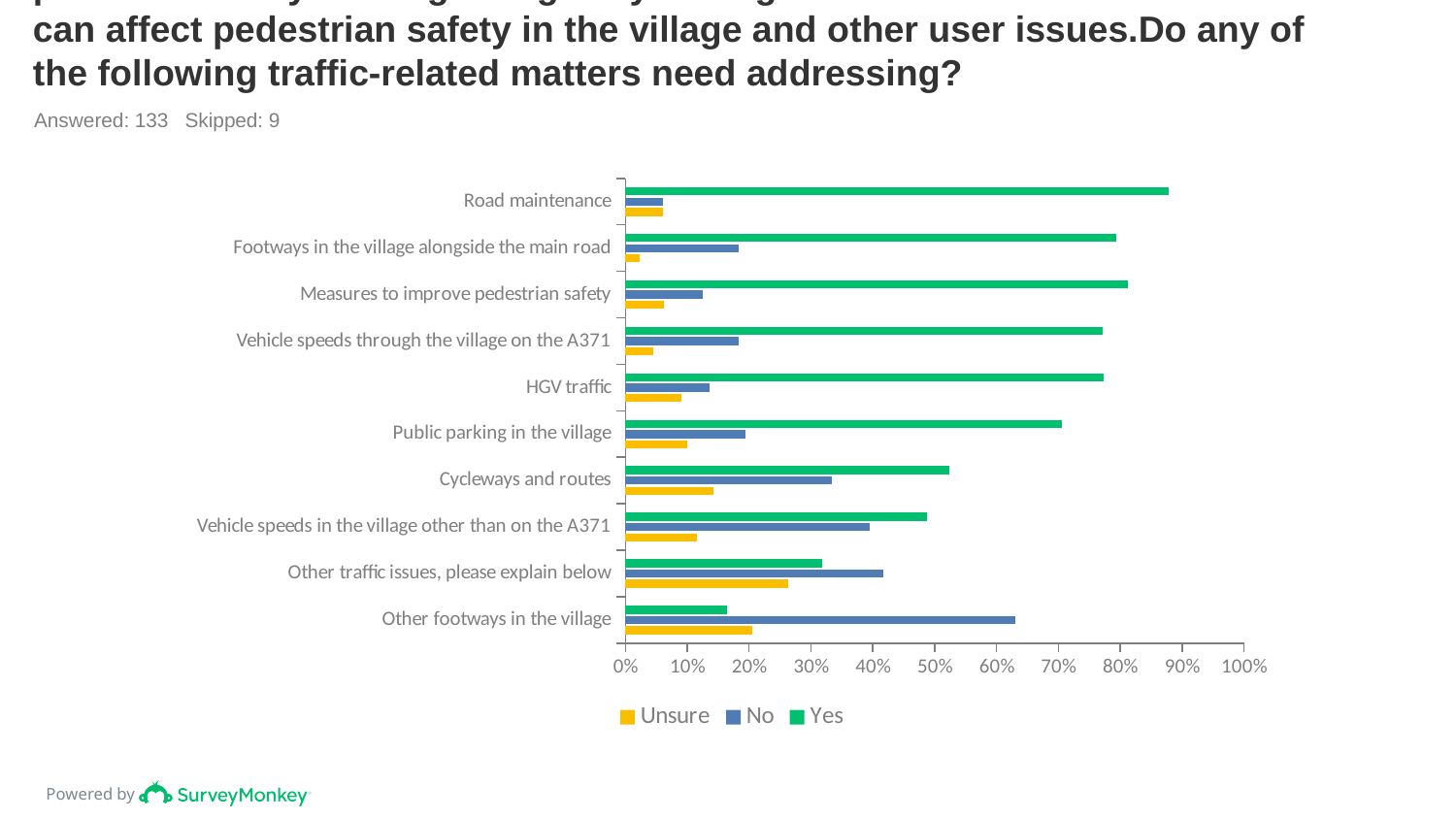
Which category has the highest 'No' value? Other footways in the village What kind of chart is shown on the slide? bar chart Which category has the highest 'Yes' value? Road maintenance Which category has the highest 'Unsure' value? Other traffic issues, please explain below Is the 'Yes' value for Road maintenance greater or less than 80%? greater Is the 'No' value for Other footways in the village greater or less than 60%? greater How many series does the legend list? 3 Is the 'Yes' value for Cycleways and routes greater or less than 60%? less Which colour represents the 'Yes' series in the legend? green How many traffic-related matters (categories) are plotted on the chart? 10 Which category has the lowest 'Yes' value? Other footways in the village For 'Other traffic issues, please explain below', which is larger: the 'Yes' value or the 'No' value? No